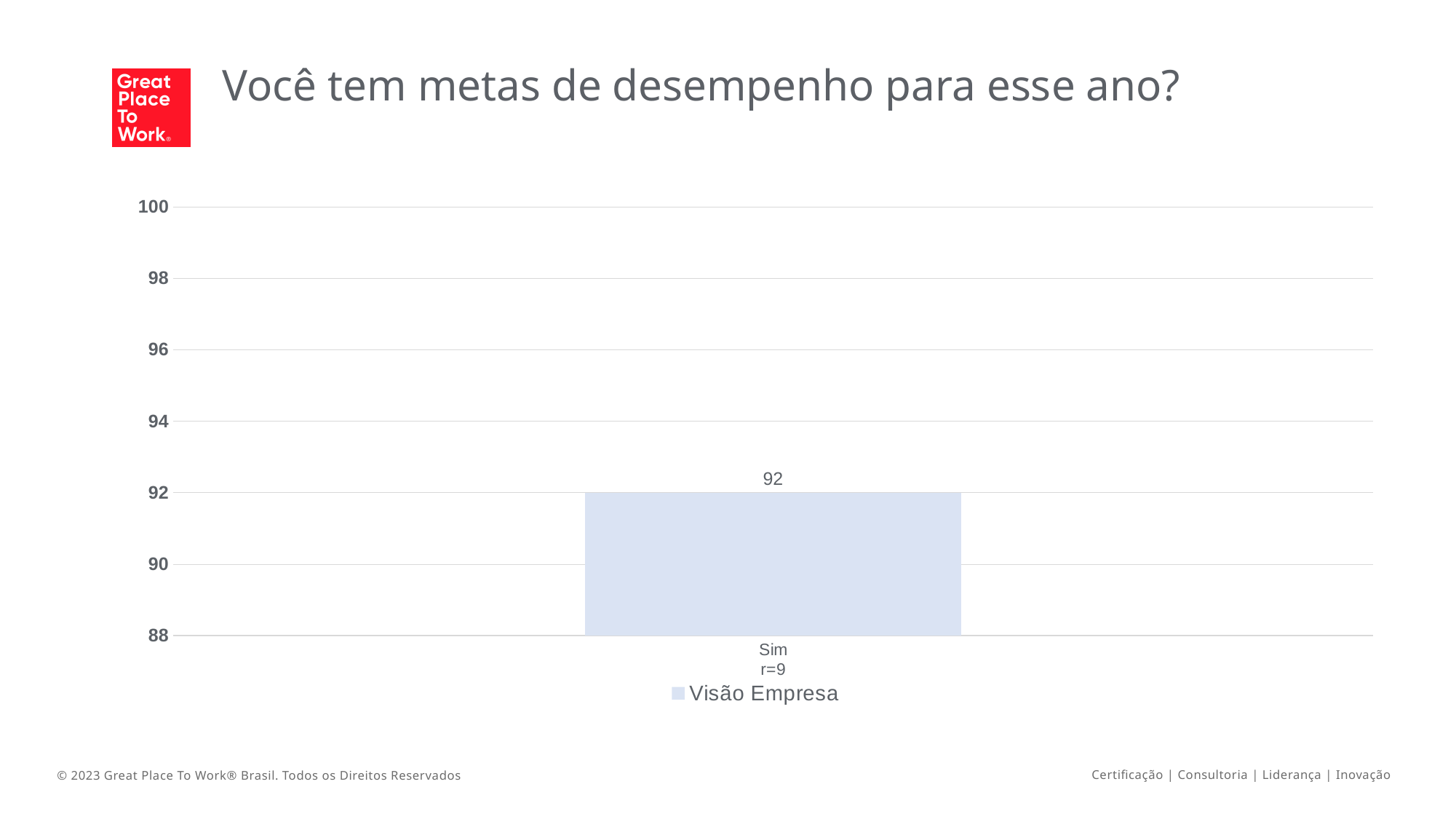
What kind of chart is shown on the slide? bar chart What is the highest value shown on the vertical axis? 100 Is the value for "Sim" greater or less than 90? greater What is the response count (r) shown under the "Sim" category? 9 Is the value for "Sim" greater or less than 94? less How many series does the legend list? 1 What is the lowest value shown on the vertical axis? 88 What is the value for the "Sim" category? 92 What is the title of the slide containing the chart? Você tem metas de desempenho para esse ano? What is the name of the series shown in the legend? Visão Empresa How many categories are plotted on the chart? 1